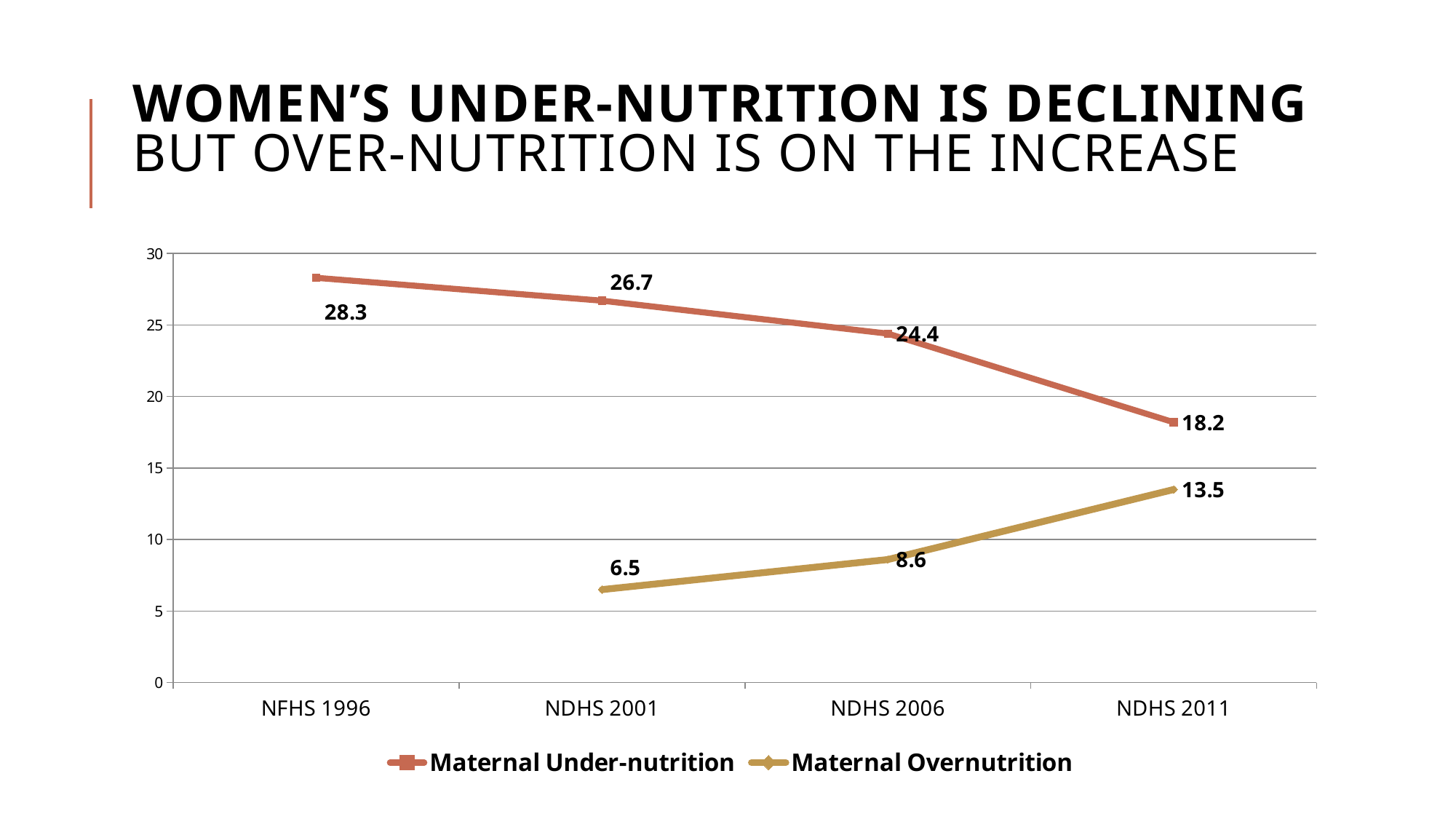
Does Maternal Overnutrition rise or fall from NDHS 2001 to NDHS 2011? Rise What kind of chart is shown on the slide? Line chart What is the value for Maternal Overnutrition at NDHS 2011? 13.5 Which is larger at NDHS 2011, Maternal Under-nutrition or Maternal Overnutrition? Maternal Under-nutrition What is the value for Maternal Under-nutrition at NFHS 1996? 28.3 What is the value for Maternal Under-nutrition at NDHS 2006? 24.4 What is the value for Maternal Overnutrition at NDHS 2001? 6.5 At which survey is Maternal Overnutrition highest? NDHS 2011 At which survey is Maternal Under-nutrition lowest? NDHS 2011 How many series does the legend list? 2 What is the difference between Maternal Under-nutrition at NFHS 1996 and at NDHS 2011? 10.1 What is the difference between Maternal Under-nutrition and Maternal Overnutrition at NDHS 2006? 15.8